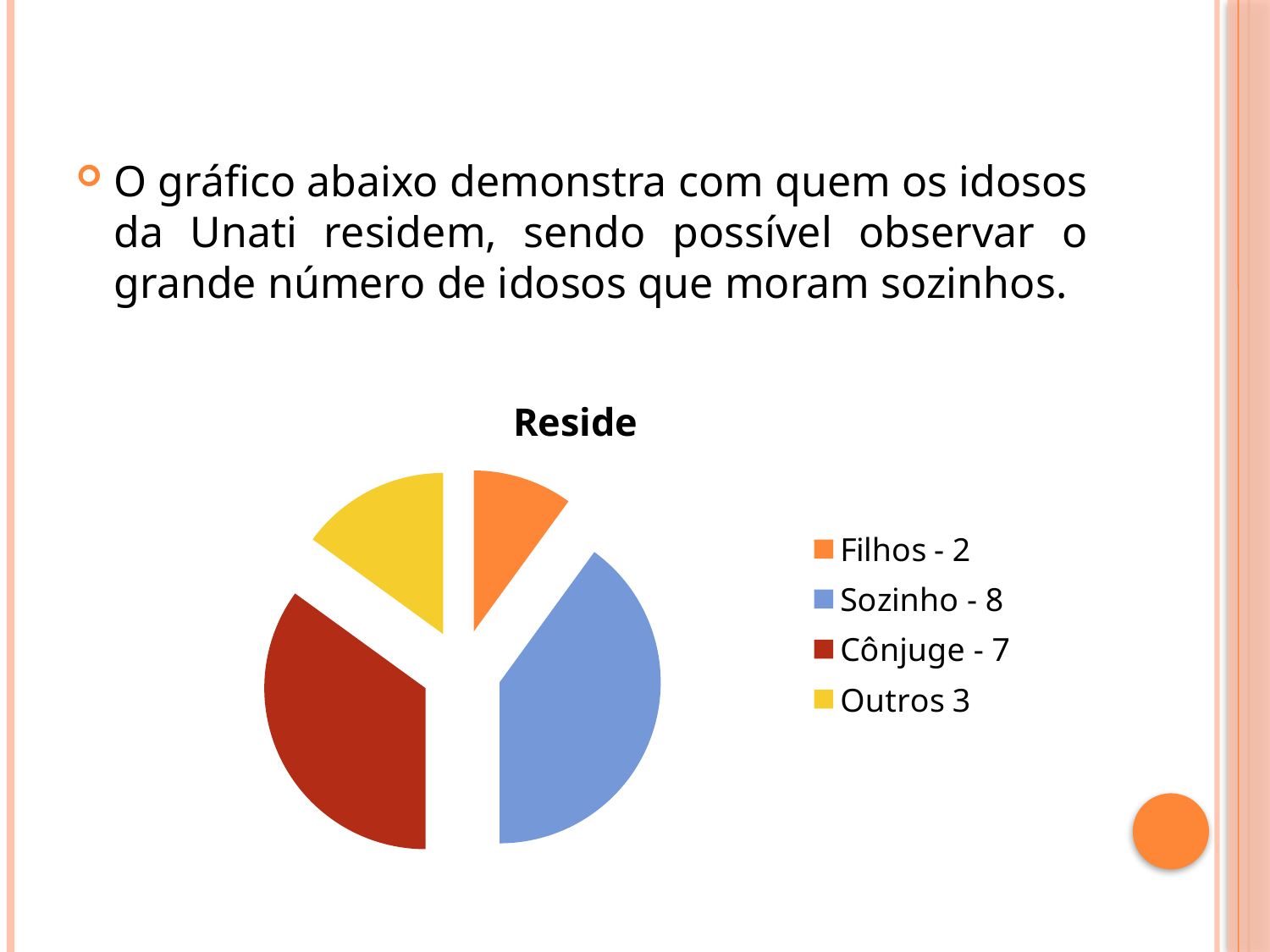
How many slices does the pie chart have? 4 What is the title of the chart? Reside What is the value for Outros? 3 Which category has the smallest slice? Filhos Which is larger, the value for Outros or the value for Filhos? Outros What share of the pie does Sozinho represent? 40% What is the value for Filhos? 2 What is the value for Cônjuge? 7 What kind of chart is shown on the slide? pie chart What is the difference between the values for Sozinho and Cônjuge? 1 Which category has the largest slice? Sozinho What is the value for Sozinho? 8